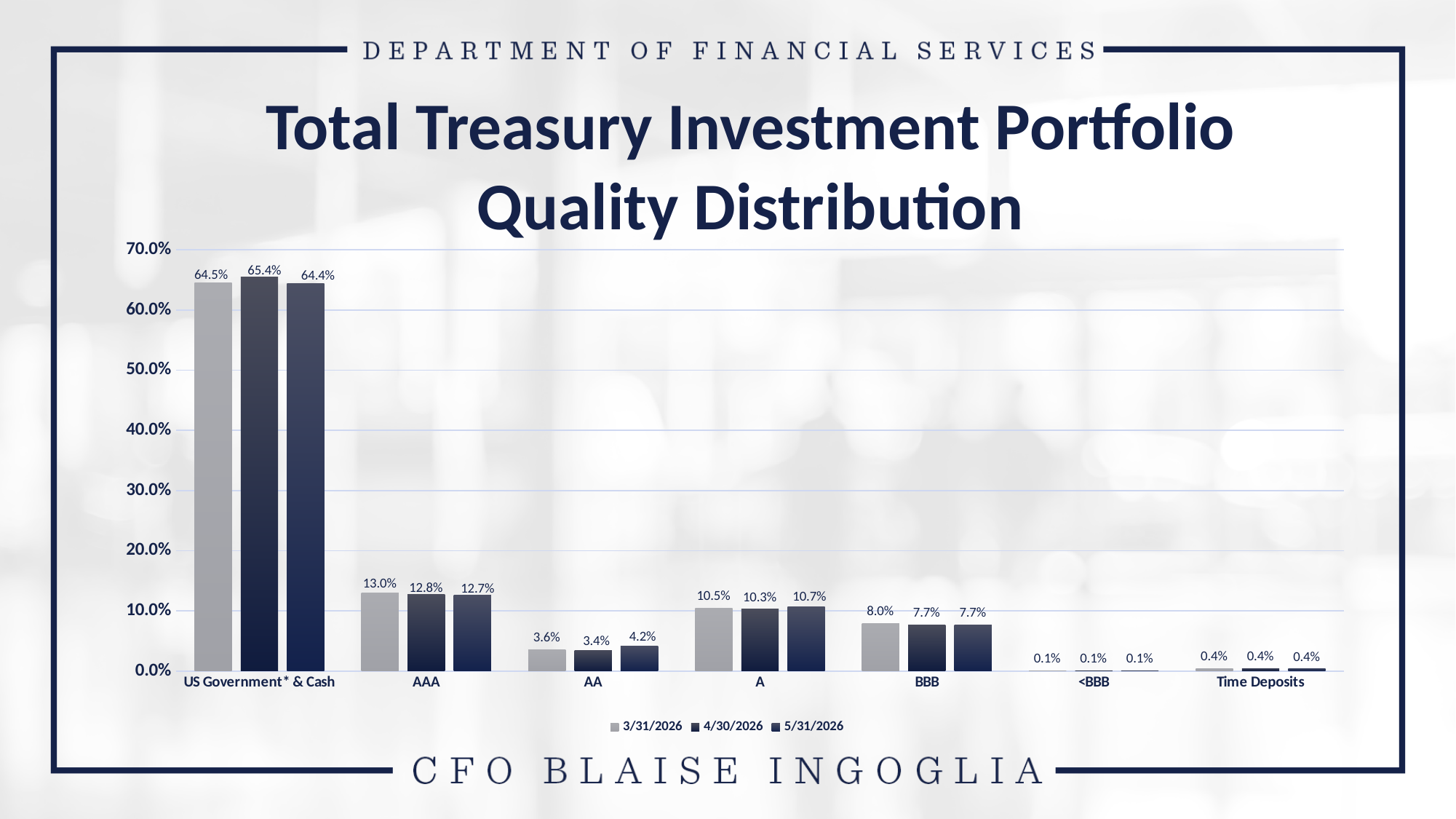
What is the title of the chart? Total Treasury Investment Portfolio Quality Distribution Which is larger for the 5/31/2026 series: the value for A or the value for BBB? A What kind of chart is shown on the slide? Bar chart What is the value for BBB in the 3/31/2026 series? 8.0% What is the value for US Government* & Cash in the 4/30/2026 series? 65.4% Which category has the lowest value in the 3/31/2026 series? <BBB How many categories are shown on the x axis? 7 What is the difference between the 3/31/2026 and 4/30/2026 values for US Government* & Cash? 0.9% How many series does the legend list? 3 What is the value for AA in the 5/31/2026 series? 4.2% Which category has the highest value in the 5/31/2026 series? US Government* & Cash What is the value for AAA in the 3/31/2026 series? 13.0%